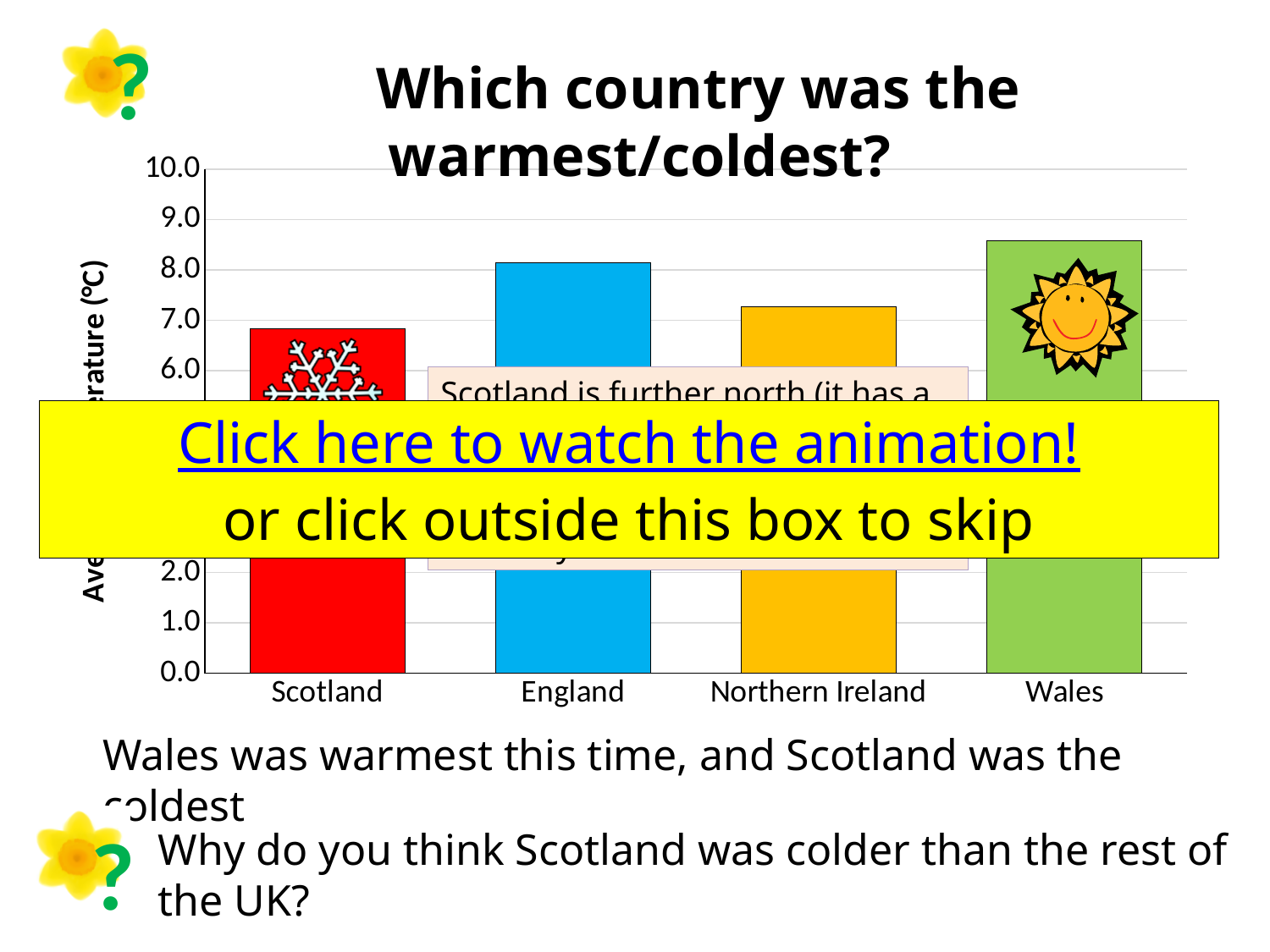
What is the highest value shown on the y axis of the chart? 10.0 Which has the higher value, Wales or Scotland? Wales Which country has the lowest bar in the chart? Scotland Is the value for Northern Ireland greater or less than 7.0? greater How many countries are shown on the x axis of the chart? 4 Is the value for Scotland greater or less than 7.0? less Is the value for Wales greater or less than 8.0? greater Which country has the highest bar in the chart? Wales What colour is the bar for Wales? green What kind of chart is shown on the slide? bar chart Which has the higher value, England or Northern Ireland? England